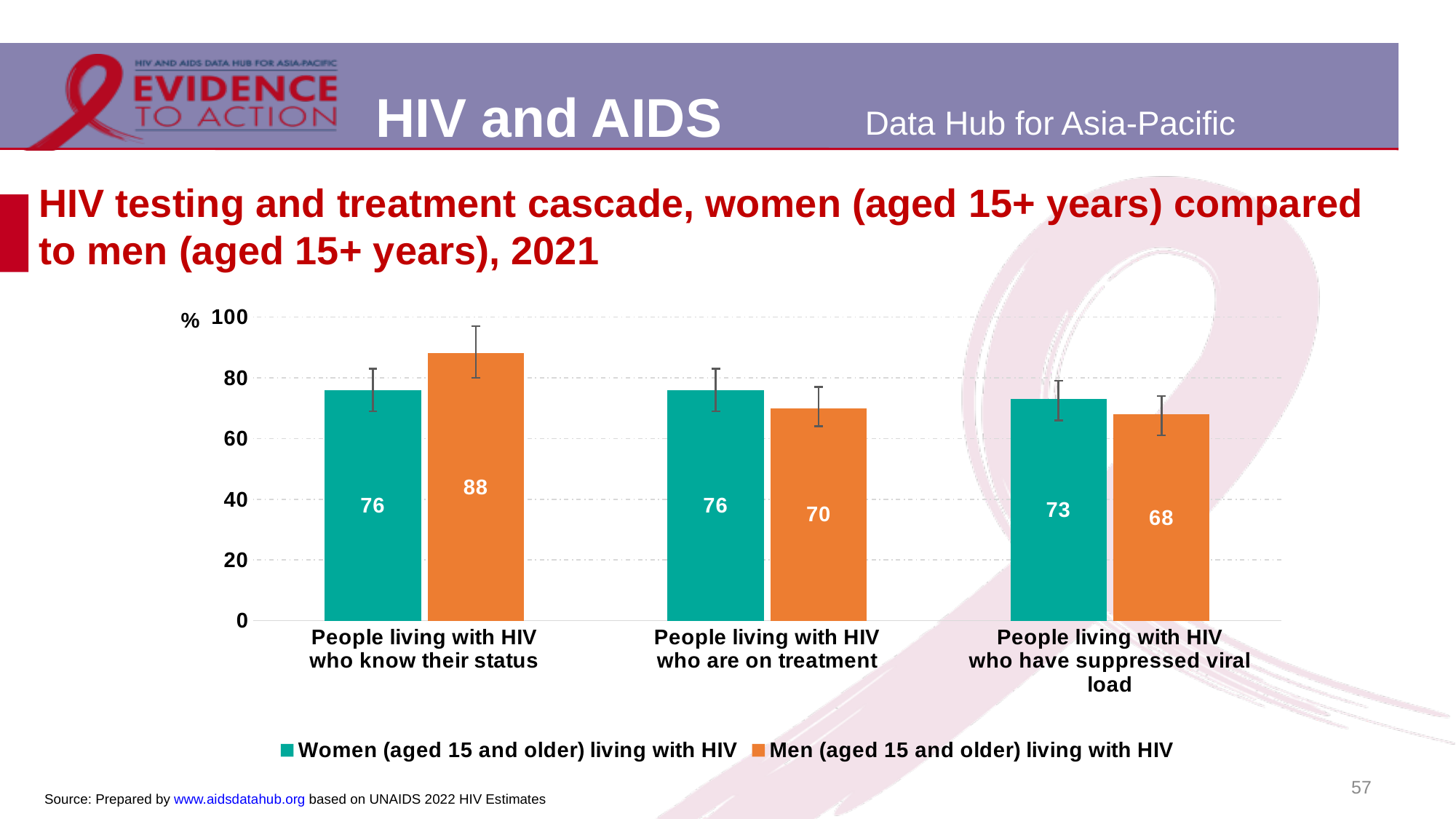
What is the value for men (aged 15 and older) living with HIV who know their status? 88 For people living with HIV who are on treatment, which is larger: the value for women or the value for men? Women How many categories are shown on the x axis? 3 Which category has the highest value for men (aged 15 and older) living with HIV? People living with HIV who know their status Which colour represents men (aged 15 and older) living with HIV? Orange What is the difference between the men's and women's values for people living with HIV who know their status? 12 What is the value for men (aged 15 and older) living with HIV who are on treatment? 70 Which category has the lowest value for men (aged 15 and older) living with HIV? People living with HIV who have suppressed viral load How many series does the legend list? 2 What is the value for women (aged 15 and older) living with HIV who know their status? 76 What is the value for women (aged 15 and older) living with HIV who have suppressed viral load? 73 What kind of chart is shown on the slide? Bar chart